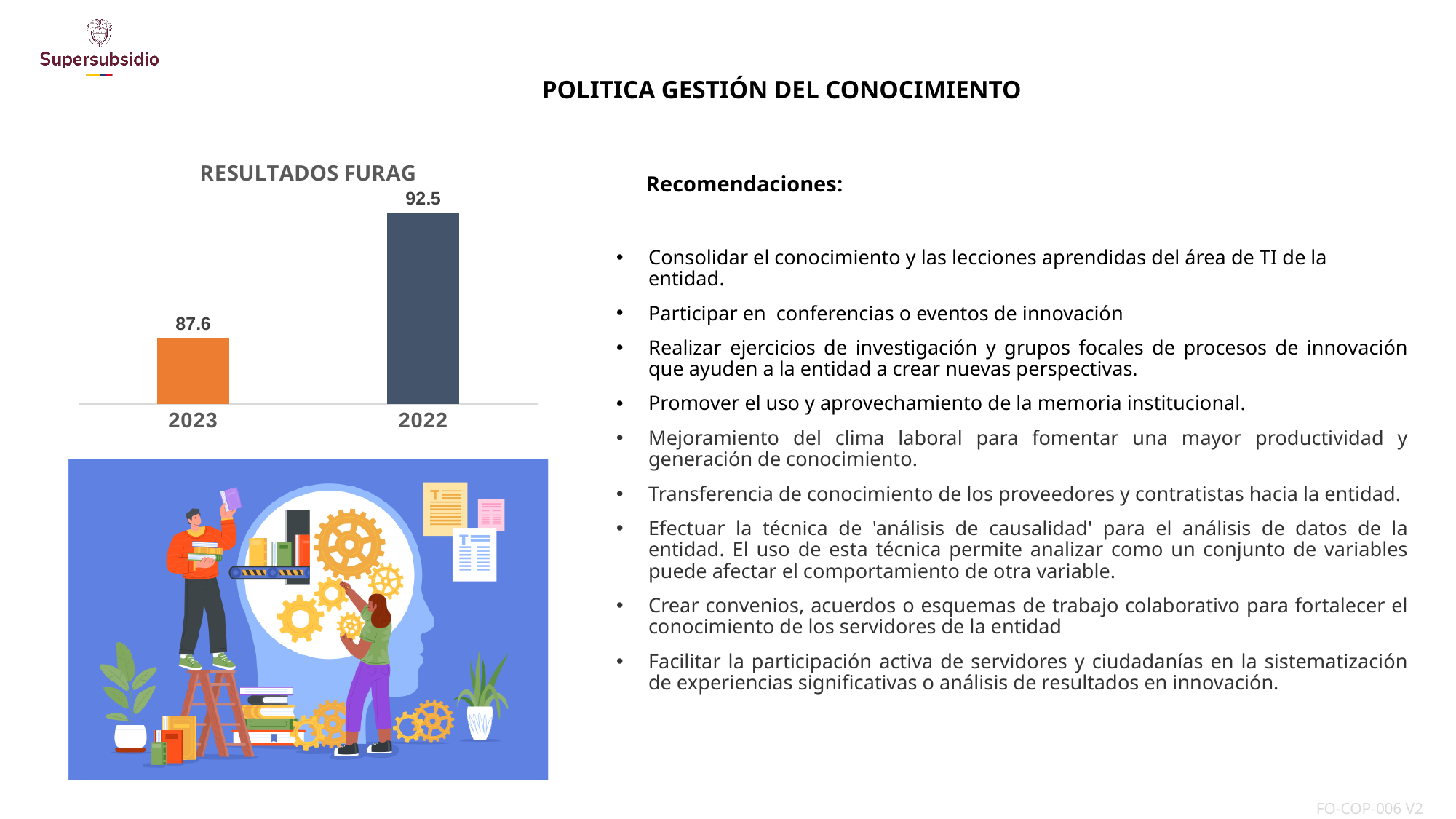
Is the value for 2023 larger or smaller than the value for 2022 in the RESULTADOS FURAG chart? smaller What colour is the bar for 2023 in the RESULTADOS FURAG chart? orange How many categories are shown in the RESULTADOS FURAG chart? 2 What kind of chart is RESULTADOS FURAG? bar chart What is the difference between the 2022 and 2023 values in the RESULTADOS FURAG chart? 4.9 What is the value for 2023 in the RESULTADOS FURAG chart? 87.6 Which year has the lowest value in the RESULTADOS FURAG chart? 2023 Which year has the highest value in the RESULTADOS FURAG chart? 2022 What is the value for 2022 in the RESULTADOS FURAG chart? 92.5 What is the title of the chart on the slide? RESULTADOS FURAG Do the values rise or fall from left to right along the x axis in the RESULTADOS FURAG chart? rise